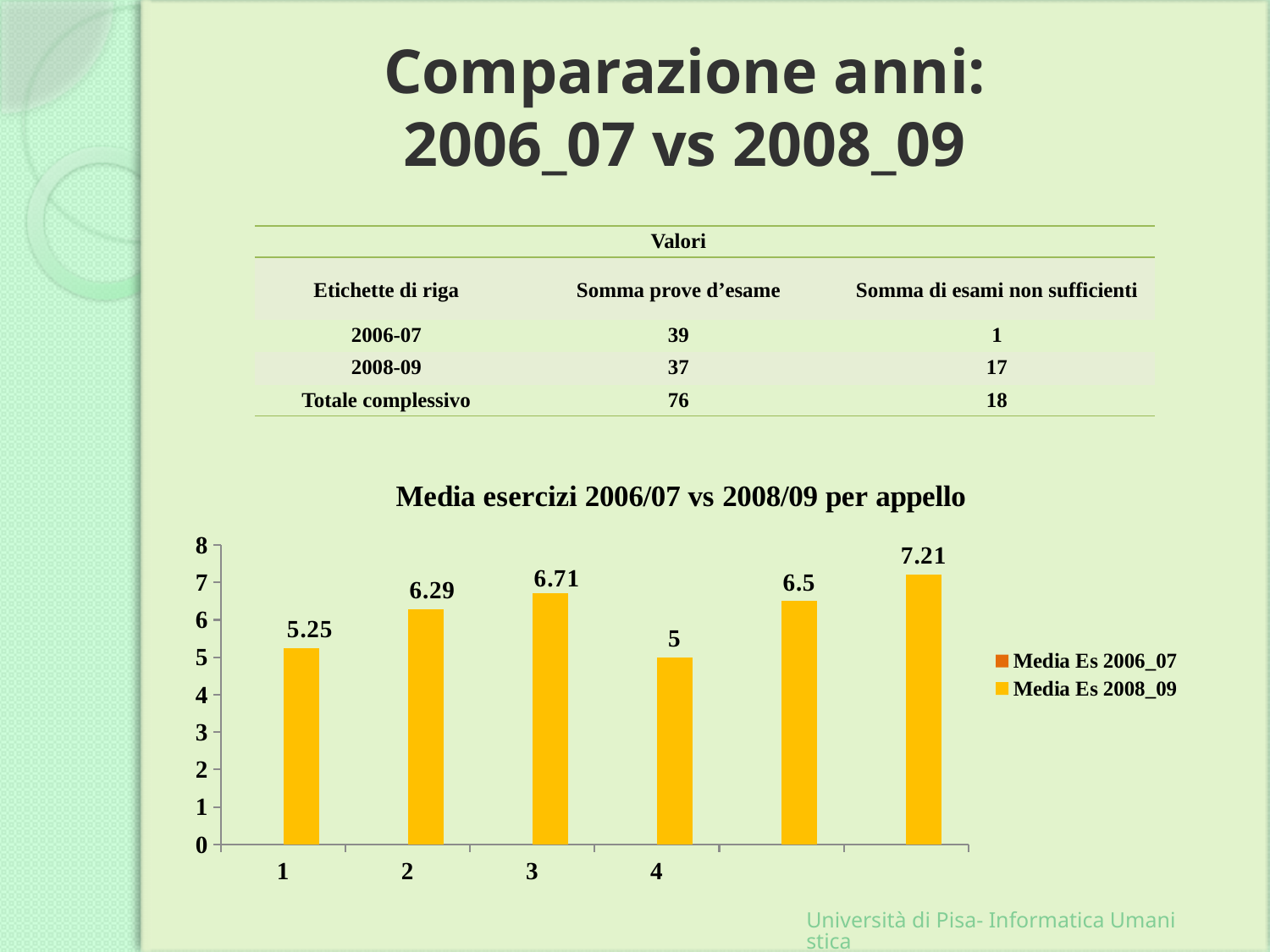
What type of chart is shown on the slide? bar chart What is the title of the chart? Media esercizi 2006/07 vs 2008/09 per appello What is the difference between the values for appello 3 and appello 1? 1.46 How many bars are plotted in the chart? 6 What is the value of the bar for appello 3? 6.71 How many series does the chart legend list? 2 Which is larger, the value for appello 2 or the value for appello 4? appello 2 Which appello has the lowest value in the chart? 4 What is the value of the bar for appello 4? 5 What is the highest value shown in the chart? 7.21 What is the value of the bar for appello 1? 5.25 What is the value of the bar for appello 2? 6.29